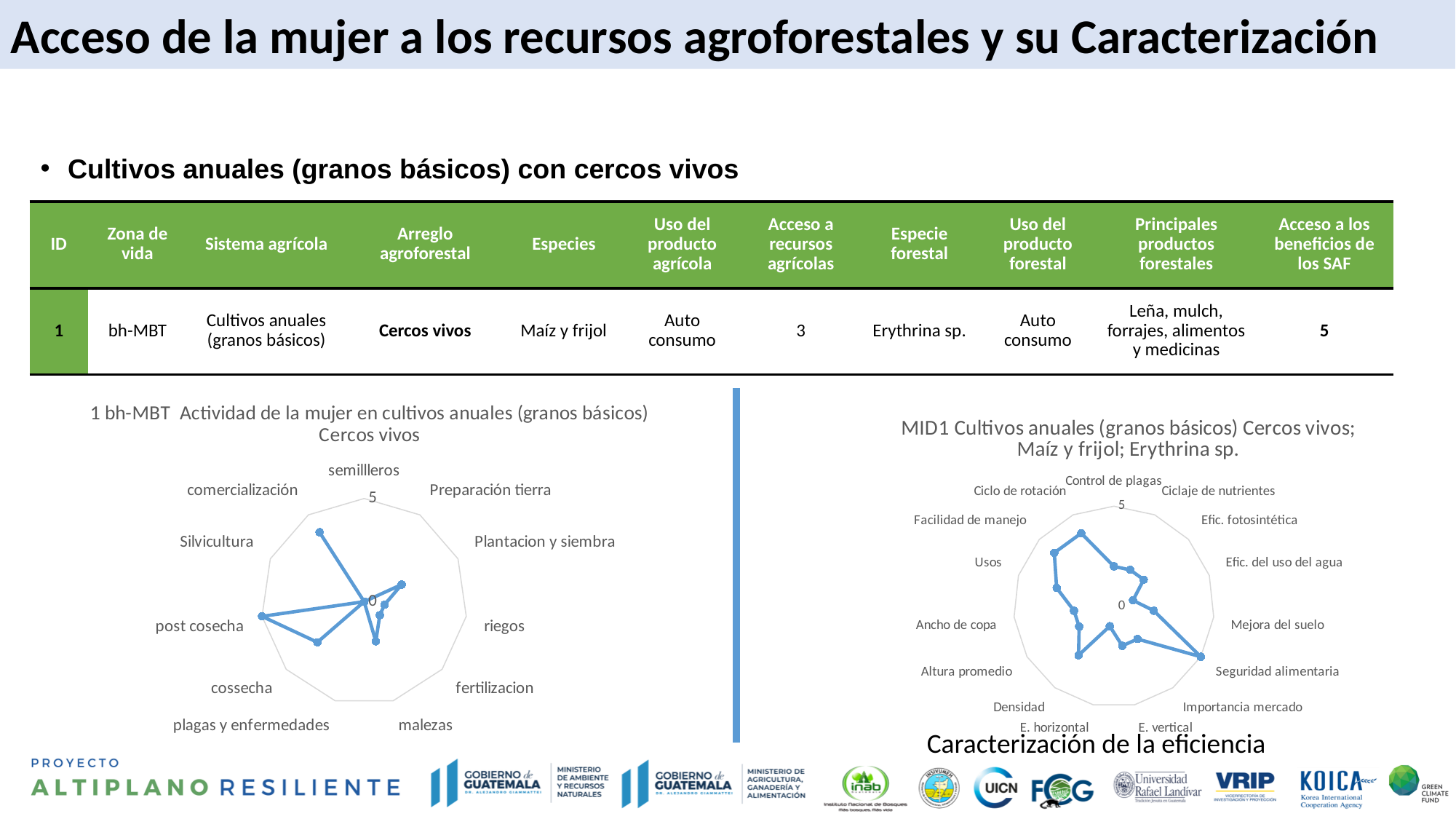
What is the maximum value shown on the radial axis of the left chart (Actividad de la mujer)? 5 What kind of chart is the left chart titled '1 bh-MBT Actividad de la mujer en cultivos anuales (granos básicos) Cercos vivos'? Radar chart What is the title of the right chart? MID1 Cultivos anuales (granos básicos) Cercos vivos; Maíz y frijol; Erythrina sp. In the left chart (Actividad de la mujer), which category has the highest value? post cosecha In the left chart (Actividad de la mujer), which is larger, the value for post cosecha or the value for semilleros? post cosecha In the left chart (Actividad de la mujer), how many categories are plotted around the radar? 11 In the left chart (Actividad de la mujer), is the value for Silvicultura greater or less than 5? less In the right chart (MID1), how many categories are plotted around the radar? 15 In the right chart (MID1), which category has the highest value? Seguridad alimentaria In the right chart (MID1), is the value for Usos greater or less than 5? less What kind of chart is the right chart titled 'MID1 Cultivos anuales (granos básicos) Cercos vivos; Maíz y frijol; Erythrina sp.'? Radar chart In the right chart (MID1), which is larger, the value for Seguridad alimentaria or the value for Control de plagas? Seguridad alimentaria